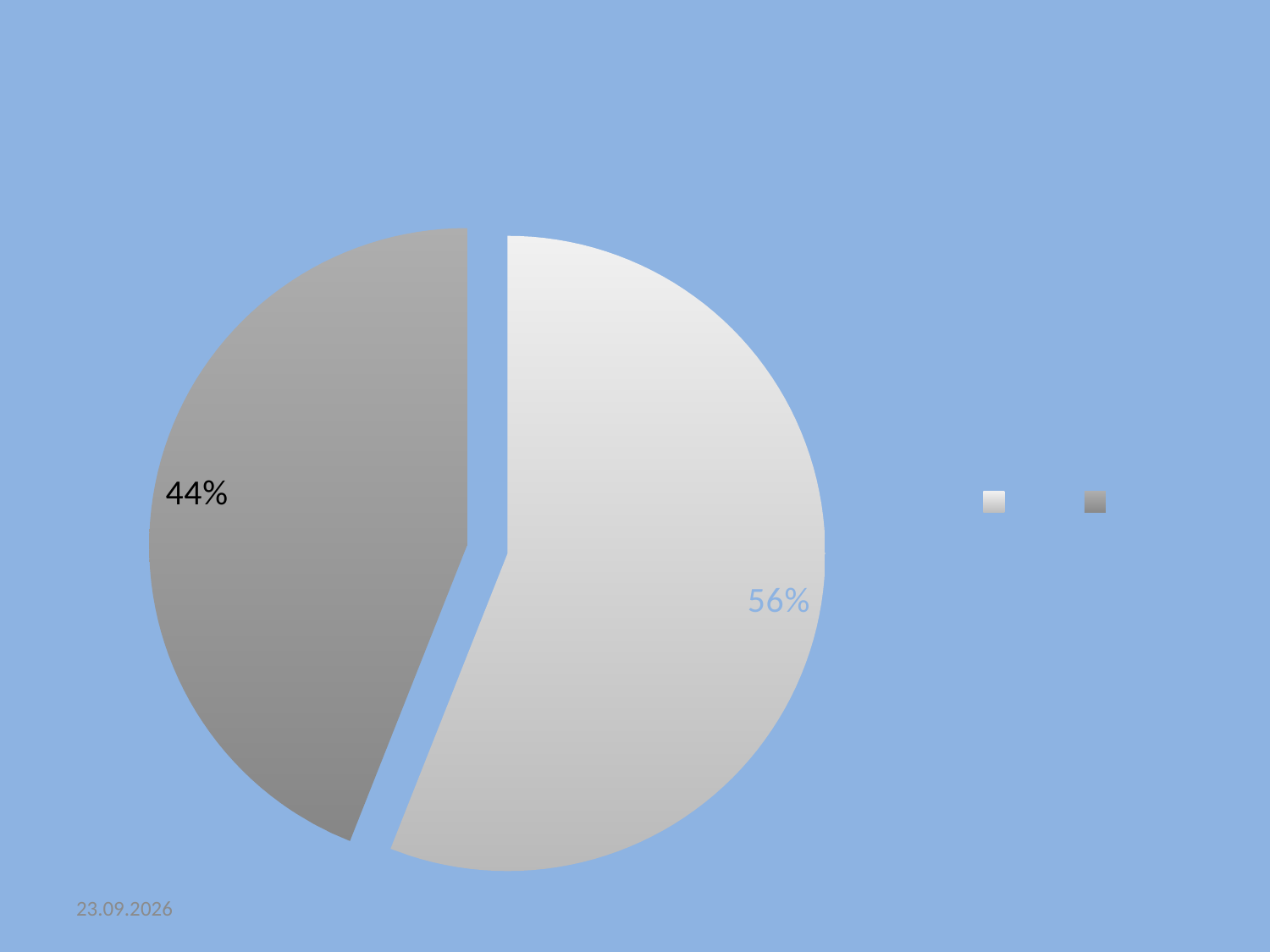
What share of the pie does the light grey slice represent? 56% Which slice of the pie chart is the largest? the light grey slice (56%) How many slices does the pie chart have? 2 Which slice is larger, the dark grey slice or the light grey slice? the light grey slice What is the difference in percentage points between the light grey slice and the dark grey slice? 12 What percentage is shown on the dark grey slice of the pie chart? 44% Is the dark grey slice greater or less than 50% of the pie? less Which slice of the pie chart is the smallest? the dark grey slice (44%) What kind of chart is shown on the slide? pie chart What percentage is shown on the light grey slice of the pie chart? 56% How many entries does the legend of the pie chart list? 2